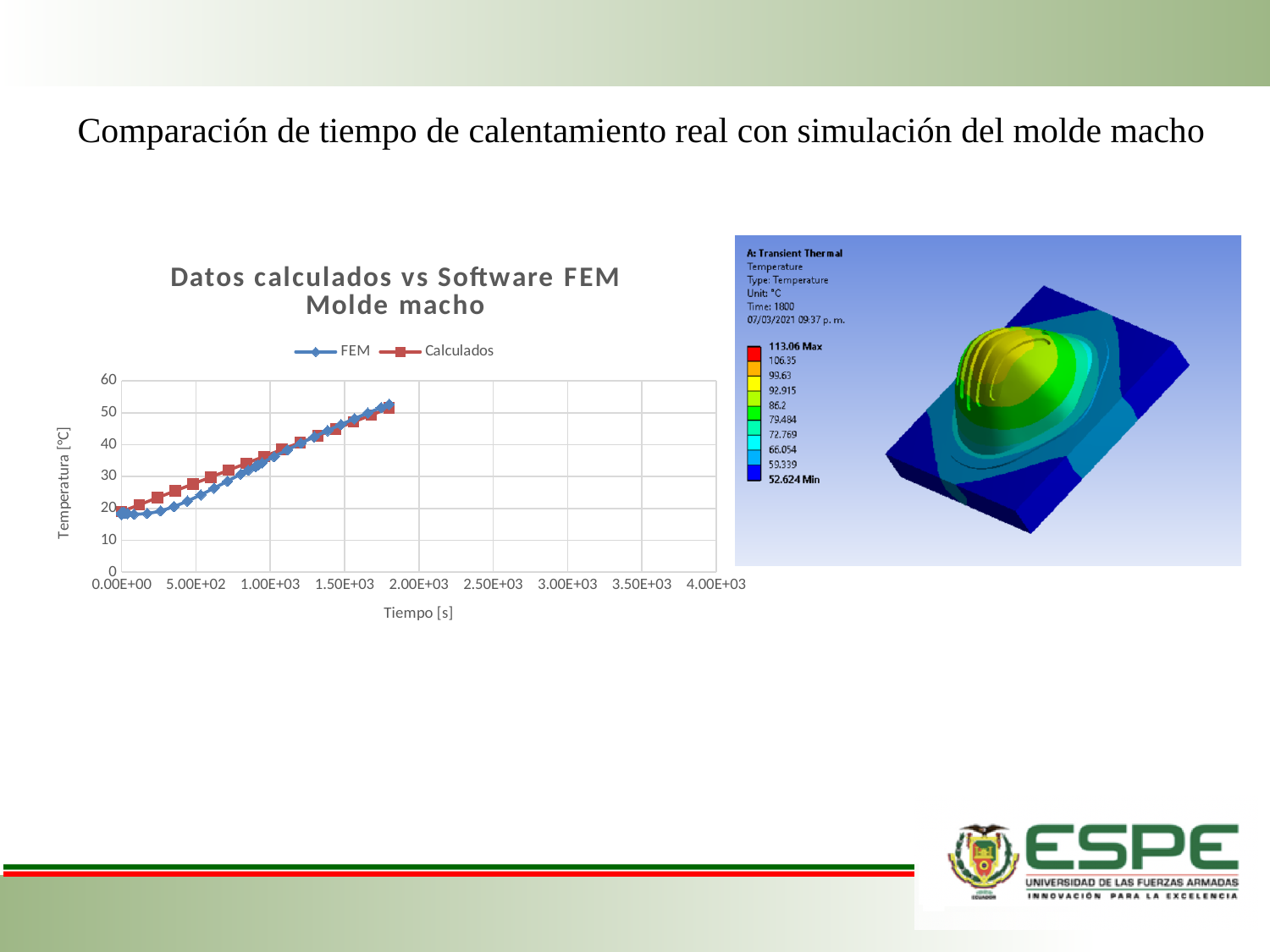
What is the title of the chart? Datos calculados vs Software FEM Molde macho Is the FEM value at 5.00E+02 s greater or less than 30? less How many series does the chart legend list? 2 Is the Calculados value at 1.00E+03 s greater or less than 30? greater Is the Calculados value at 1.50E+03 s greater or less than 40? greater Do the temperature values rise or fall as time increases along the x axis? rise What kind of chart is shown on the slide? line chart What are the names of the two series in the chart legend? FEM and Calculados At 5.00E+02 s, which series has the higher temperature, FEM or Calculados? Calculados What is the highest value shown on the y axis of the chart? 60